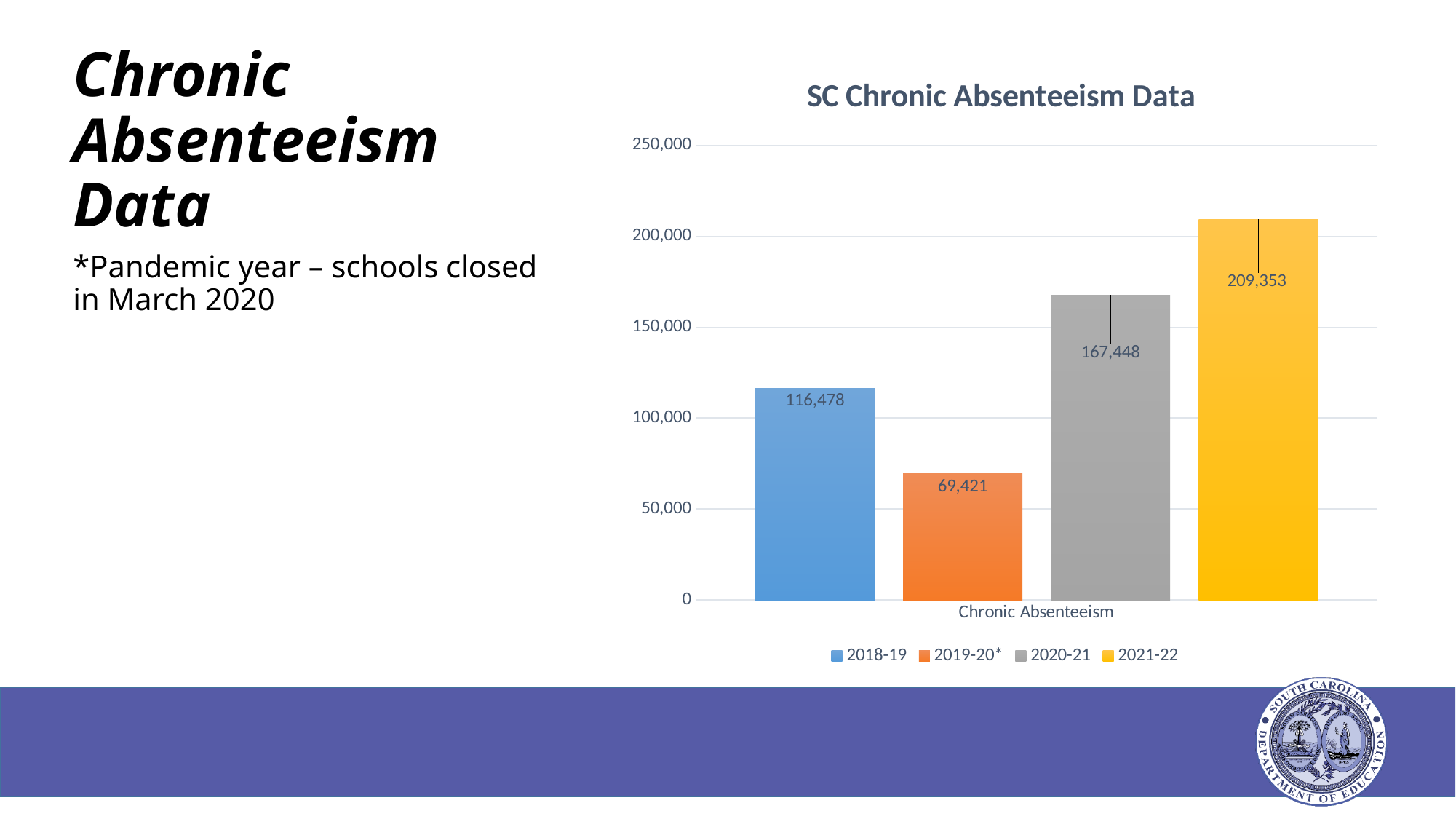
What is the chronic absenteeism value for 2018-19? 116,478 What is the difference between the 2021-22 and 2020-21 chronic absenteeism values? 41,905 What is the difference between the 2018-19 and 2019-20* chronic absenteeism values? 47,057 What is the chronic absenteeism value for 2020-21? 167,448 What is the title of the chart? SC Chronic Absenteeism Data Is the value for 2021-22 greater or less than 200,000? greater How many series does the legend list? 4 Which school year has the lowest chronic absenteeism value? 2019-20* Which school year has the highest chronic absenteeism value? 2021-22 What is the chronic absenteeism value for 2021-22? 209,353 What is the chronic absenteeism value for 2019-20*? 69,421 Which is larger, the value for 2018-19 or the value for 2020-21? 2020-21